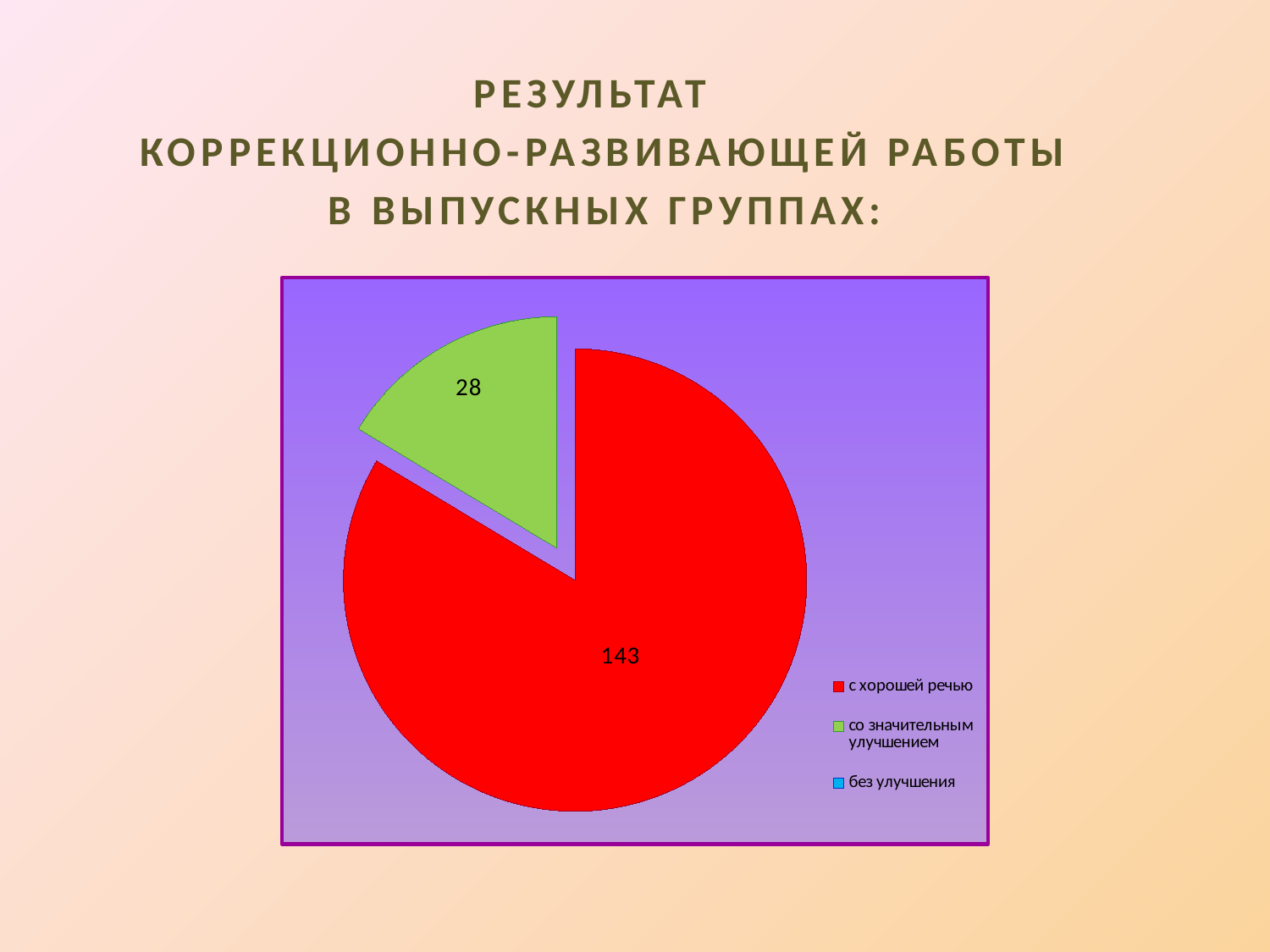
What is the value of the slice for "с хорошей речью"? 143 What kind of chart is shown on the slide? pie chart What is the difference between the values for "с хорошей речью" and "со значительным улучшением"? 115 What colour is the slice for "с хорошей речью"? red What is the value of the slice for "со значительным улучшением"? 28 Of the two slices with printed values, which one is smaller? со значительным улучшением How many slices with printed data labels are visible in the pie? 2 Which is larger: the value for "с хорошей речью" or for "со значительным улучшением"? с хорошей речью Which category has the largest slice of the pie? с хорошей речью Which legend entry has no visible slice in the pie? без улучшения How many categories are listed in the legend? 3